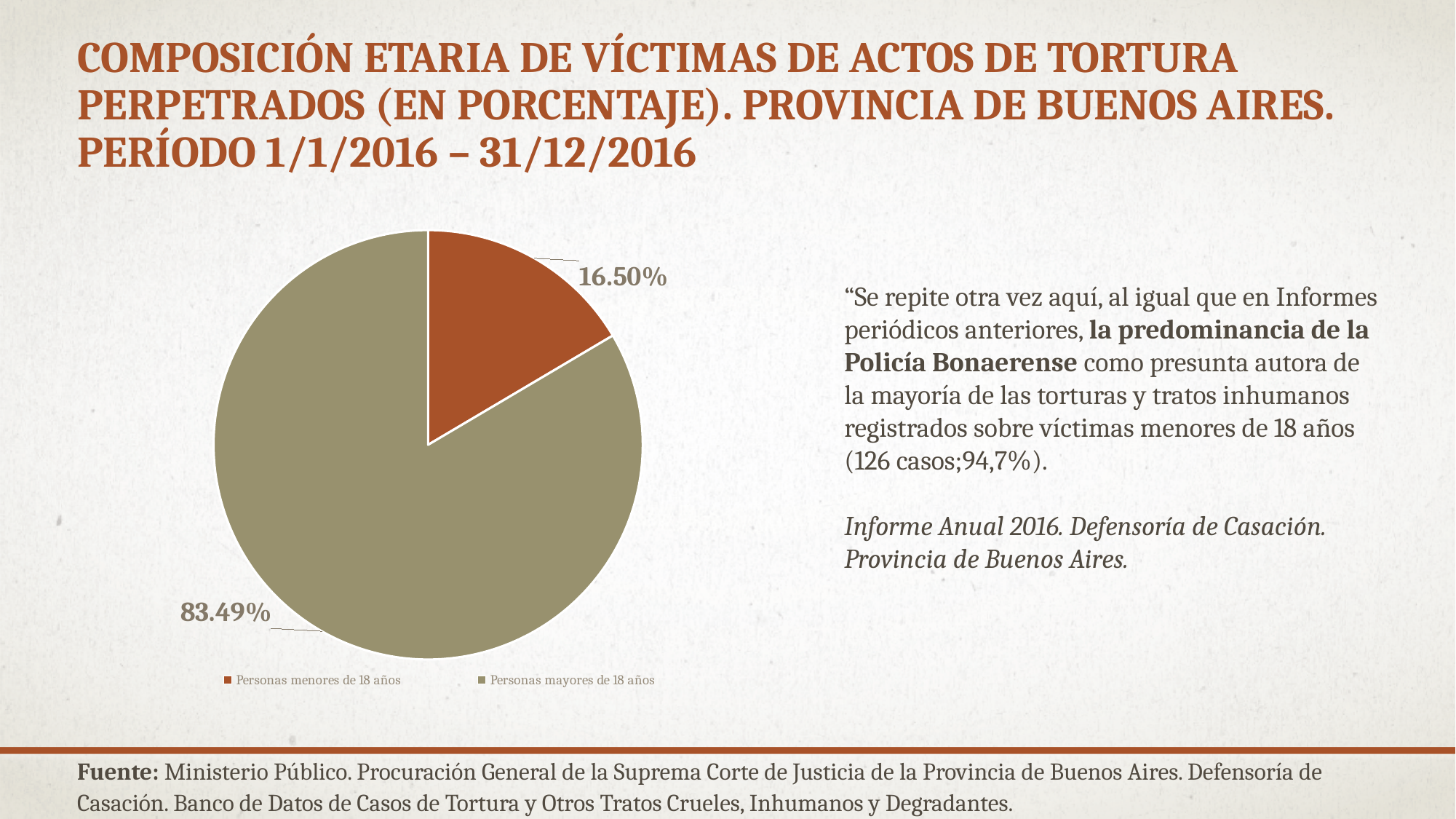
How many entries does the legend list? 2 What is the difference in percentage points between 'Personas mayores de 18 años' and 'Personas menores de 18 años'? 66.99% How many slices does the pie chart have? 2 Which is larger: the share for 'Personas menores de 18 años' or the share for 'Personas mayores de 18 años'? Personas mayores de 18 años Which category has the largest share of the pie? Personas mayores de 18 años What percentage of the pie corresponds to 'Personas mayores de 18 años'? 83.49% What percentage of the pie corresponds to 'Personas menores de 18 años'? 16.50% What kind of chart is shown on the slide? pie chart Which category has the smallest share of the pie? Personas menores de 18 años What colour is the slice for 'Personas mayores de 18 años'? olive green What colour is the slice for 'Personas menores de 18 años'? reddish brown